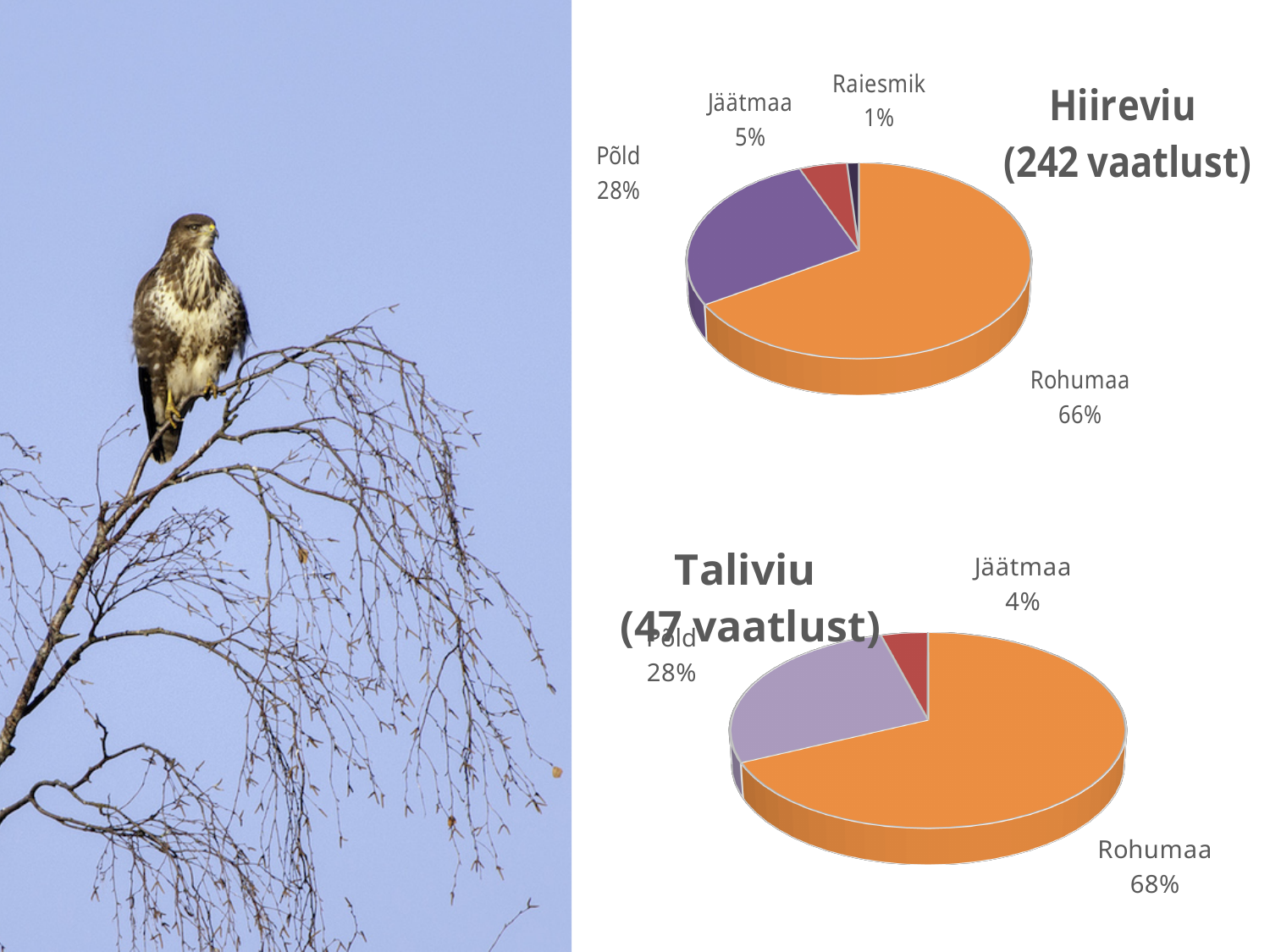
In the Taliviu (47 vaatlust) chart, how many categories are shown? 3 In the Hiireviu (242 vaatlust) chart, what share does Põld have? 28% In the Hiireviu (242 vaatlust) chart, what share does Rohumaa have? 66% What kind of chart is the Taliviu (47 vaatlust) chart? Pie chart In the Hiireviu (242 vaatlust) chart, which category has the smallest share? Raiesmik In the Taliviu (47 vaatlust) chart, what share does Jäätmaa have? 4% In the Hiireviu (242 vaatlust) chart, which category has the largest share? Rohumaa In the Taliviu (47 vaatlust) chart, which category has the smallest share? Jäätmaa In the Hiireviu (242 vaatlust) chart, what is the difference between the Rohumaa and Põld shares? 38% In the Hiireviu (242 vaatlust) chart, what share does Raiesmik have? 1% In the Taliviu (47 vaatlust) chart, what share does Rohumaa have? 68% In the Hiireviu (242 vaatlust) chart, how many categories are shown? 4